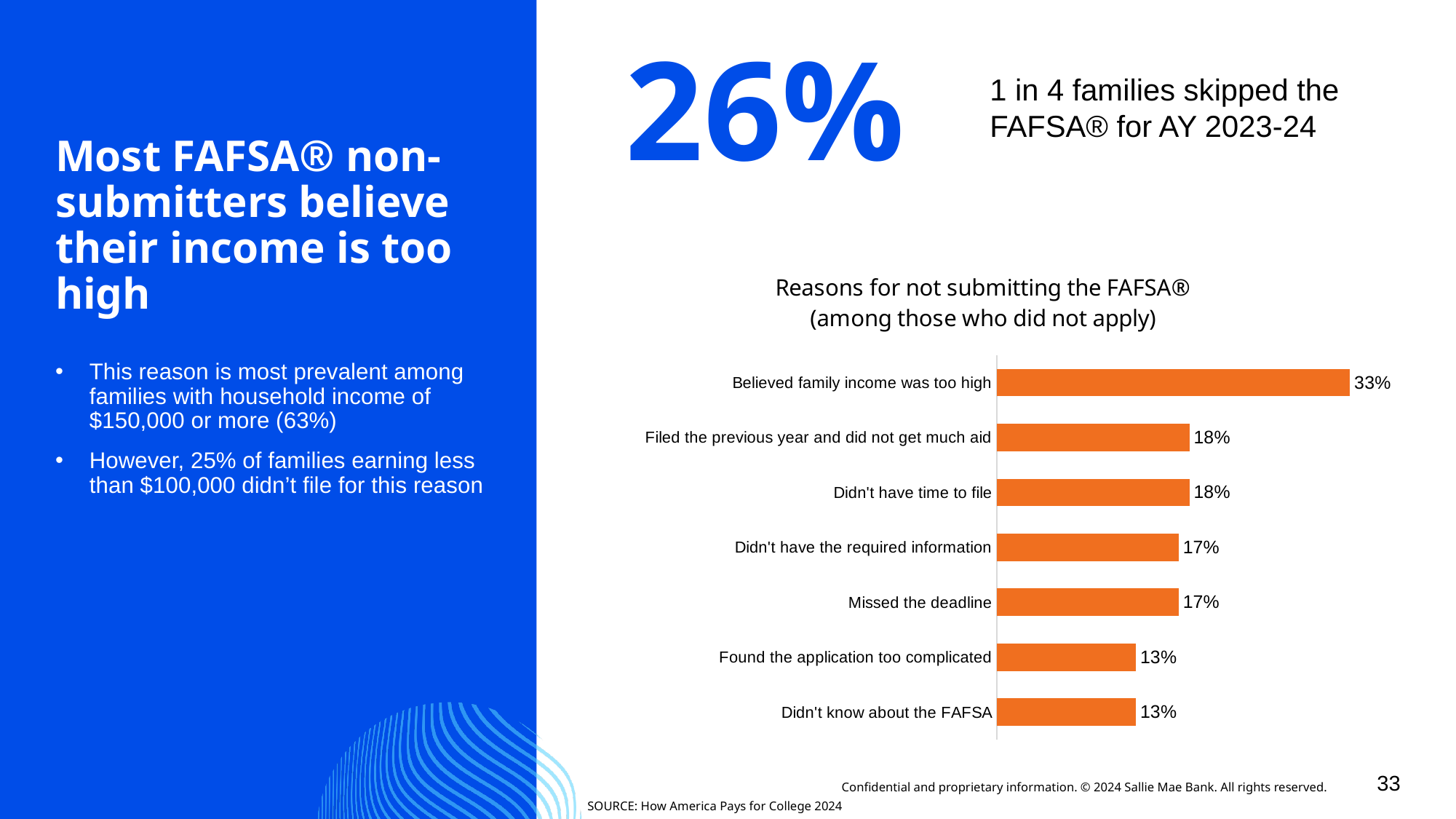
What percentage of non-submitters missed the deadline? 17% What type of chart is shown on the slide? Bar chart What percentage of non-submitters believed family income was too high? 33% Which is larger: the value for "Didn't have time to file" or the value for "Missed the deadline"? Didn't have time to file What is the difference between "Believed family income was too high" and "Filed the previous year and did not get much aid"? 15 percentage points How many reasons are listed in the chart? 7 What colour are the bars in the chart? Orange What is the value for "Didn't have time to file"? 18% What is the difference between "Didn't have the required information" and "Found the application too complicated"? 4 percentage points Which reason for not submitting the FAFSA has the highest percentage? Believed family income was too high What is the value for "Didn't know about the FAFSA"? 13% What is the title of the chart? Reasons for not submitting the FAFSA® (among those who did not apply)